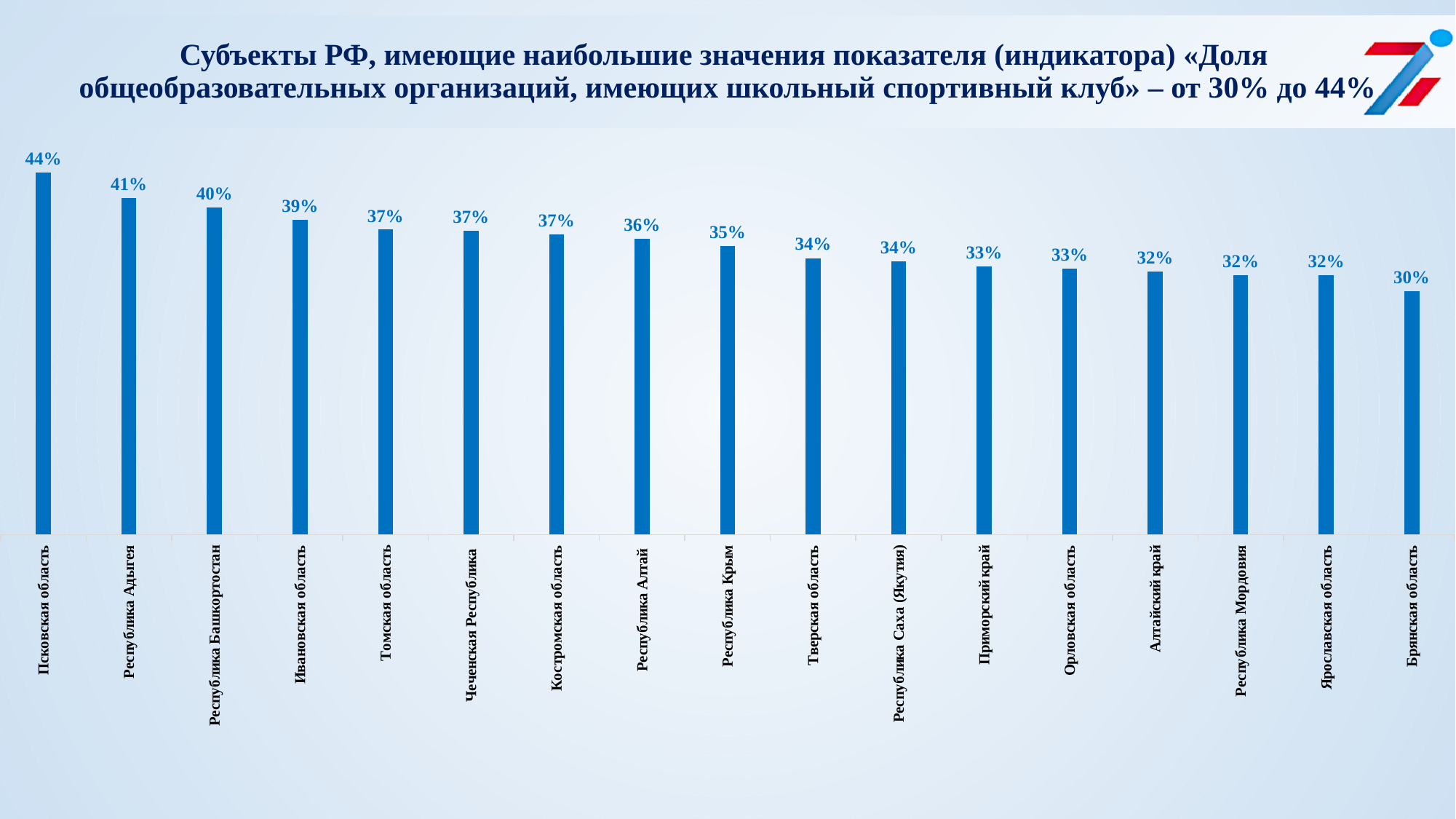
How many regions are shown in the chart? 17 What is the difference between the values for Псковская область and Брянская область? 14% What is the value for Псковская область? 44% What kind of chart is shown on the slide? bar chart Which region has the lowest value? Брянская область What is the difference between the values for Республика Адыгея and Ивановская область? 2% Which is larger, the value for Республика Башкортостан or the value for Республика Алтай? Республика Башкортостан What is the value for Брянская область? 30% Do the values rise or fall from left to right along the x axis? fall Which region has the highest value? Псковская область What is the value for Республика Крым? 35% What is the value for Республика Саха (Якутия)? 34%